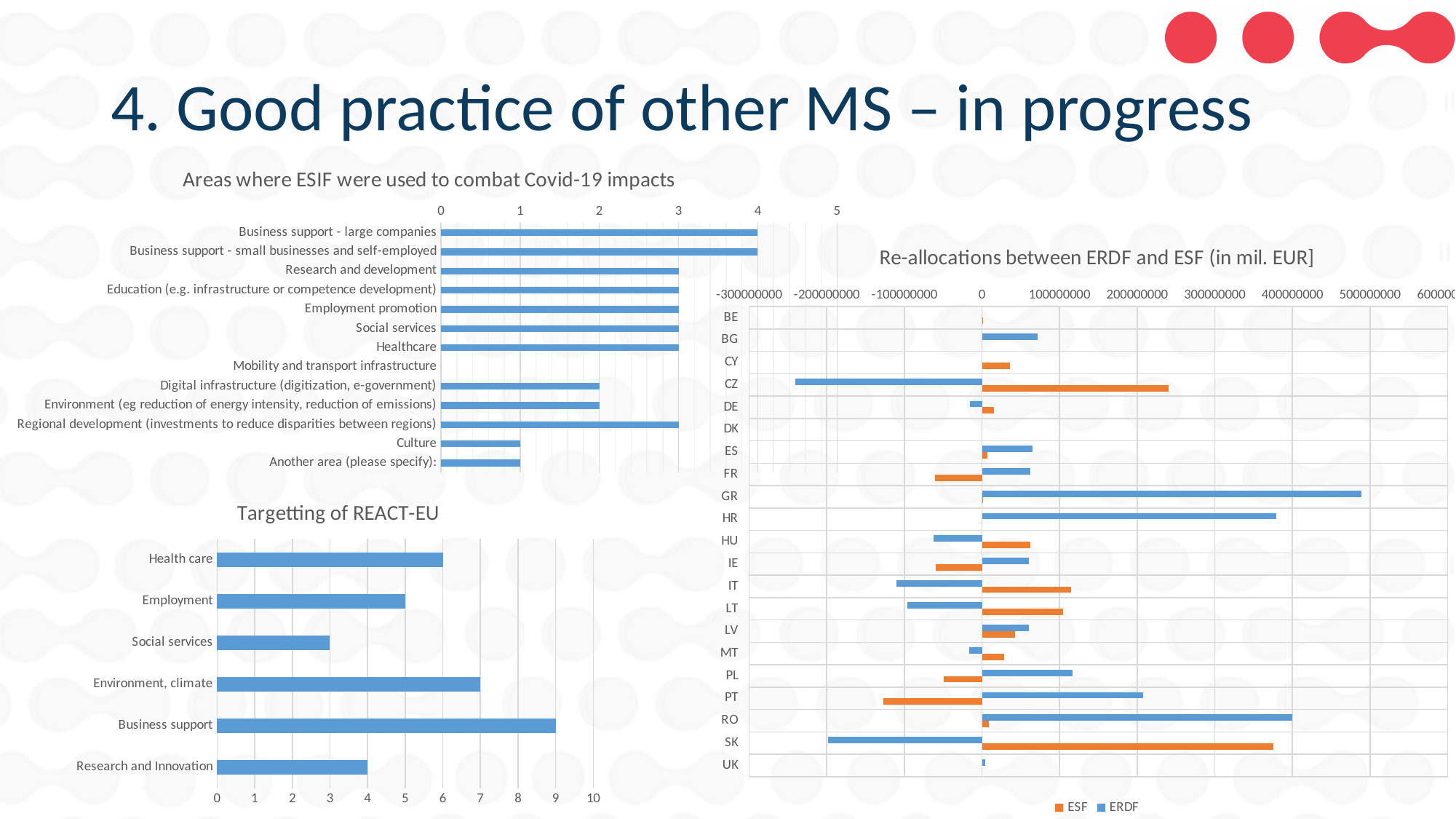
In the 'Areas where ESIF were used to combat Covid-19 impacts' chart, which is larger: Healthcare or Digital infrastructure (digitization, e-government)? Healthcare How many categories are shown in the 'Targetting of REACT-EU' chart? 6 In the 'Areas where ESIF were used to combat Covid-19 impacts' chart, which category has no bar at all? Mobility and transport infrastructure In the 'Areas where ESIF were used to combat Covid-19 impacts' chart, what is the value for Business support - large companies? 4 In the 'Targetting of REACT-EU' chart, what is the difference between Environment, climate and Health care? 1 How many series does the legend of the 'Re-allocations between ERDF and ESF (in mil. EUR)' chart list? 2 In the 'Targetting of REACT-EU' chart, which category has the highest value? Business support In the 'Areas where ESIF were used to combat Covid-19 impacts' chart, what is the value for Culture? 1 What kind of chart is 'Re-allocations between ERDF and ESF (in mil. EUR)'? bar chart In the 'Targetting of REACT-EU' chart, what is the value for Business support? 9 In the 'Targetting of REACT-EU' chart, what is the value for Social services? 3 In the 'Re-allocations between ERDF and ESF (in mil. EUR)' chart, is the ERDF value for GR greater or less than 400000000? greater